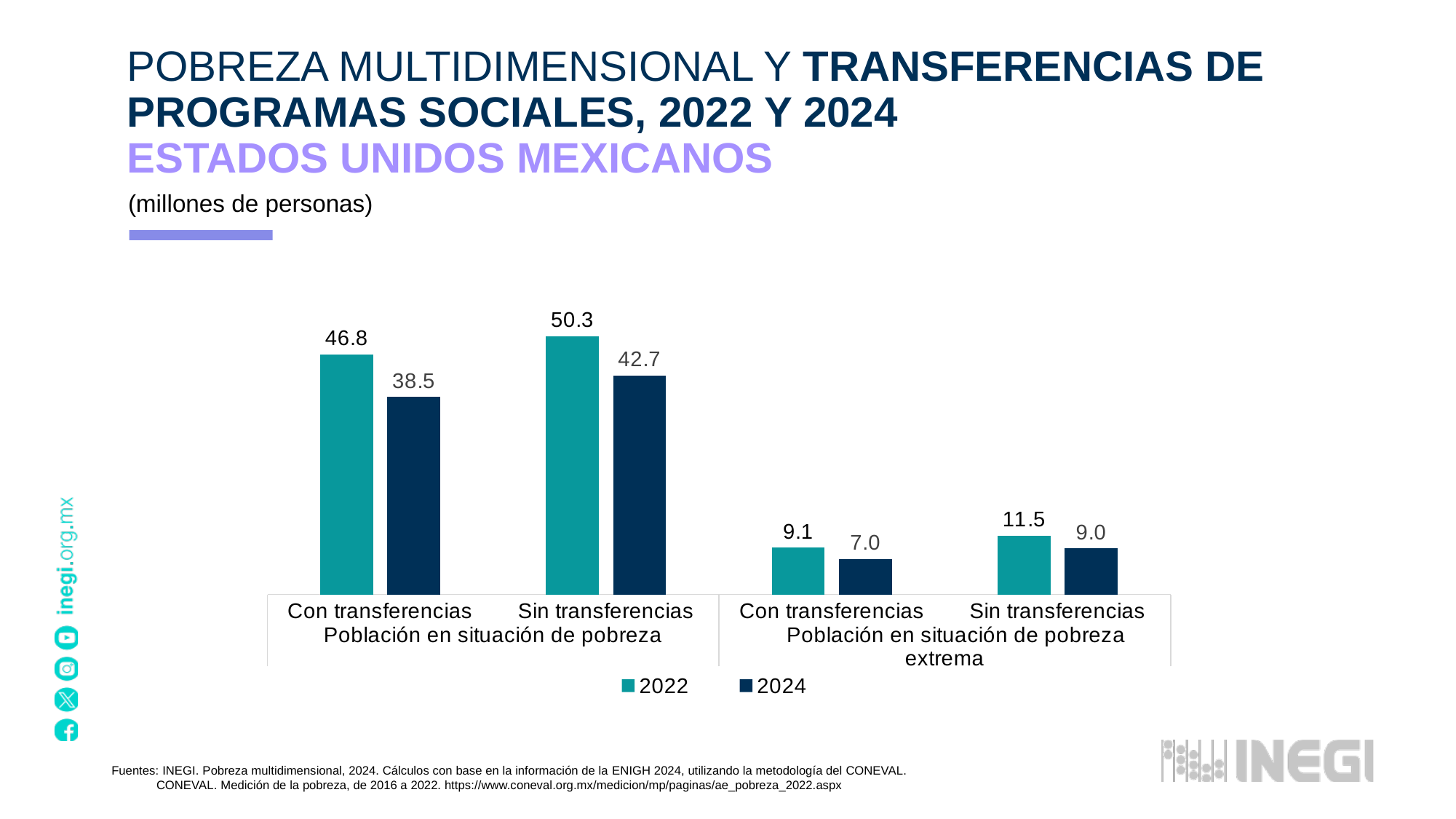
What is the 2024 value for 'Con transferencias' under 'Población en situación de pobreza extrema'? 7.0 What is the 2022 value for 'Sin transferencias' under 'Población en situación de pobreza extrema'? 11.5 Which is larger: the 2024 value for 'Sin transferencias' in 'Población en situación de pobreza' or the 2022 value for 'Con transferencias' in the same group? 2022 Con transferencias (46.8) What is the 2022 value for 'Con transferencias' under 'Población en situación de pobreza'? 46.8 What is the difference between the 2022 and 2024 values for 'Con transferencias' under 'Población en situación de pobreza'? 8.3 Which bar has the lowest value on the chart? Con transferencias, Población en situación de pobreza extrema, 2024 What is the difference between the 2022 and 2024 values for 'Sin transferencias' under 'Población en situación de pobreza extrema'? 2.5 What unit is stated for the values in the chart? millones de personas What is the 2024 value for 'Sin transferencias' under 'Población en situación de pobreza'? 42.7 Which bar has the highest value on the chart? Sin transferencias, Población en situación de pobreza, 2022 How many series does the legend list? 2 What kind of chart is shown on the slide? Bar chart